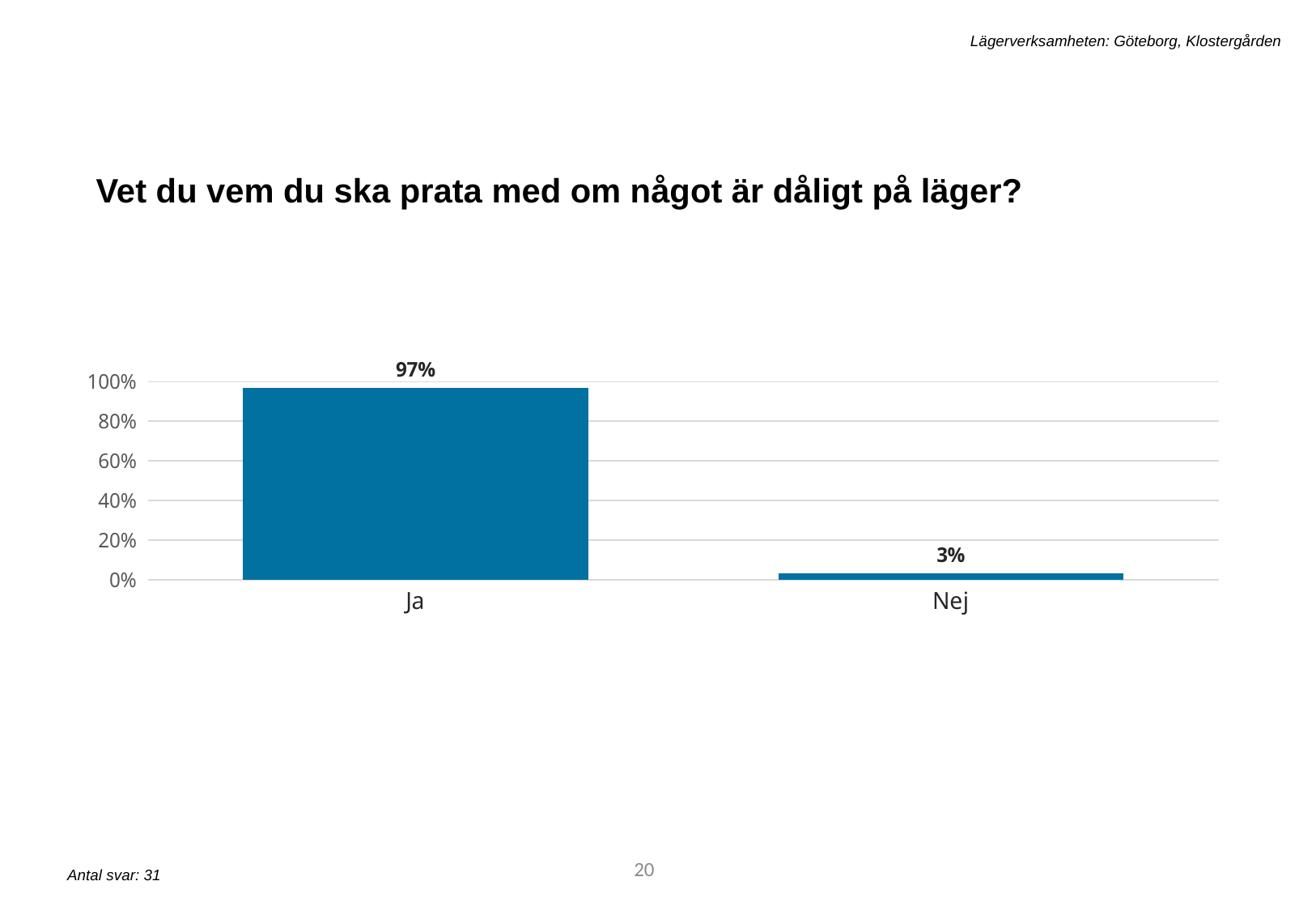
How many categories are shown on the x axis? 2 How many responses (Antal svar) does the slide report? 31 What is the title of the chart? Vet du vem du ska prata med om något är dåligt på läger? What is the difference between the values for Ja and Nej? 94% Is the value for Nej greater or less than 20%? less Which category has the highest value? Ja What is the value for Ja? 97% What is the value for Nej? 3% Which is larger, the value for Ja or the value for Nej? Ja What kind of chart is shown on the slide? bar chart Is the value for Ja greater or less than 80%? greater Which category has the lowest value? Nej